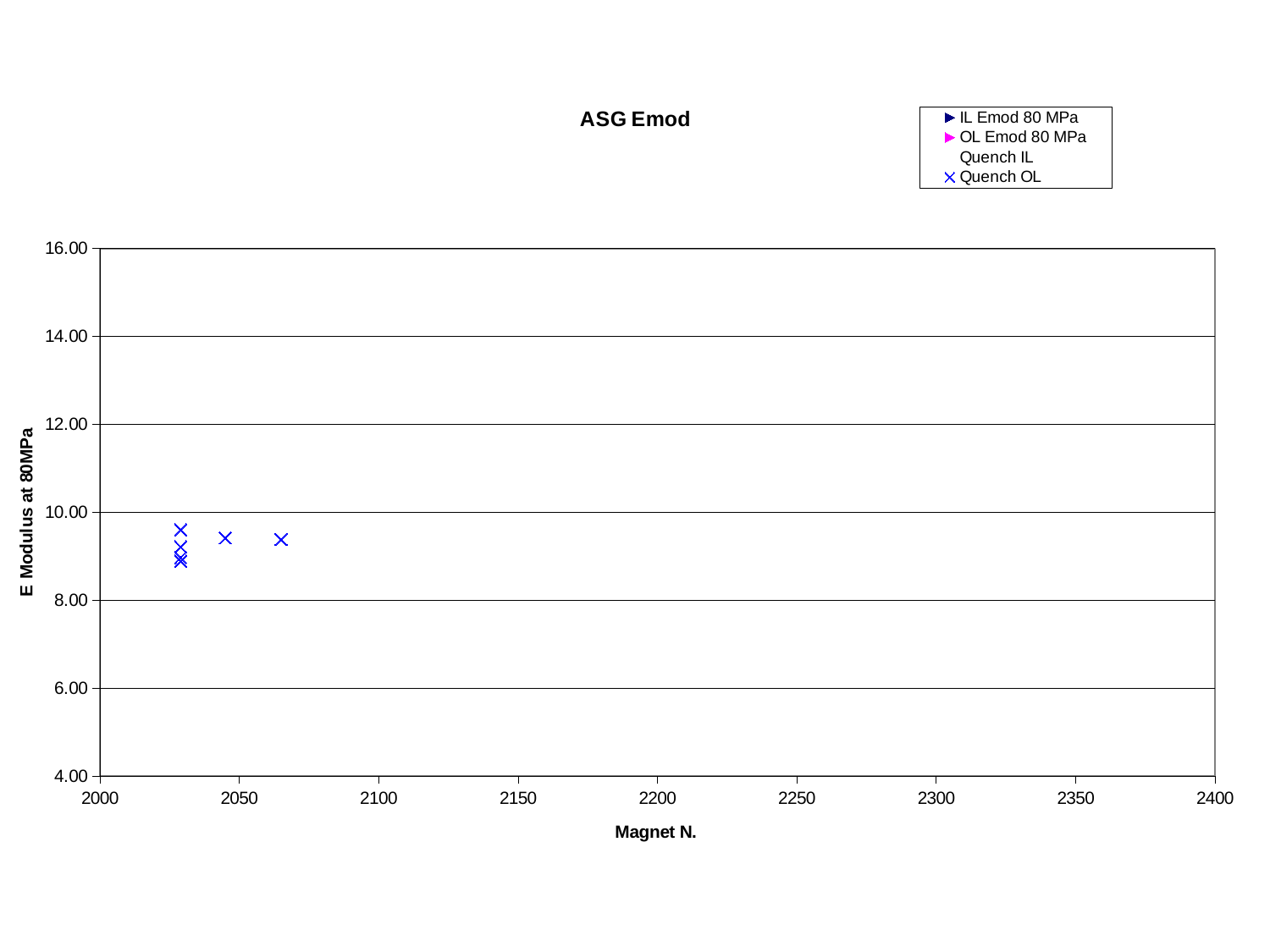
Is the value for the Quench OL point near Magnet N. 2065 greater or less than 8.00? greater Is the value for the Quench OL point near Magnet N. 2045 greater or less than 10.00? less Are the lowest Quench OL points near Magnet N. 2030 greater or less than 8.00? greater How many series does the legend of the ASG Emod chart list? 4 What is the title of the chart? ASG Emod What is the label of the vertical axis of the chart? E Modulus at 80MPa What kind of chart is shown on the slide? scatter chart